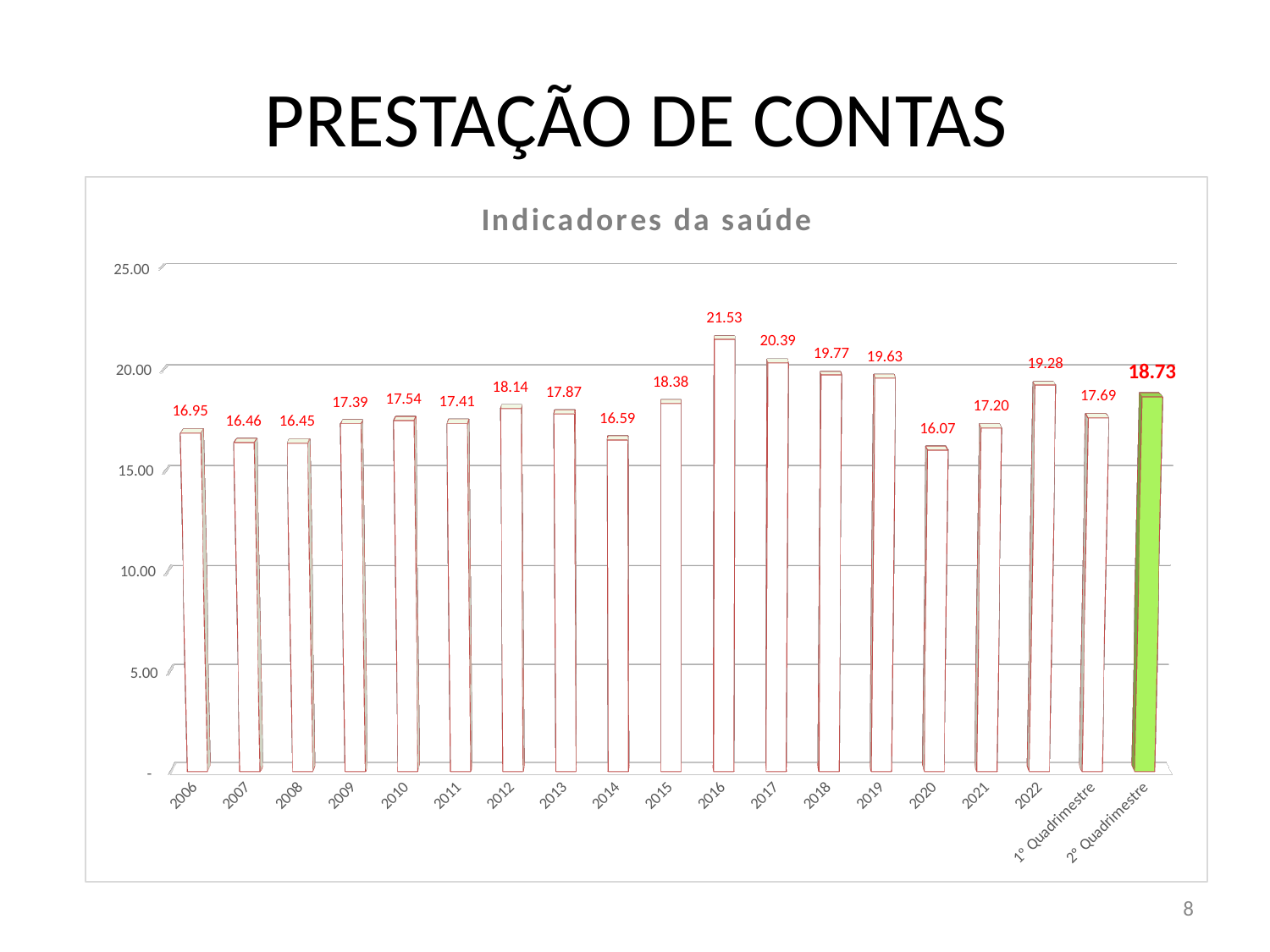
What is the value for 2º Quadrimestre? 18.73 What is the title of the chart? Indicadores da saúde What is the value for 2020? 16.07 What is the value for 2012? 18.14 How many categories are shown on the x axis? 19 What kind of chart is shown? Bar chart Which category has the lowest value? 2020 Which category has the highest value? 2016 What is the value for 2016? 21.53 What is the difference between the values for 2016 and 2017? 1.14 What is the difference between the values for 2º Quadrimestre and 1º Quadrimestre? 1.04 Which is larger, the value for 2018 or the value for 2014? 2018